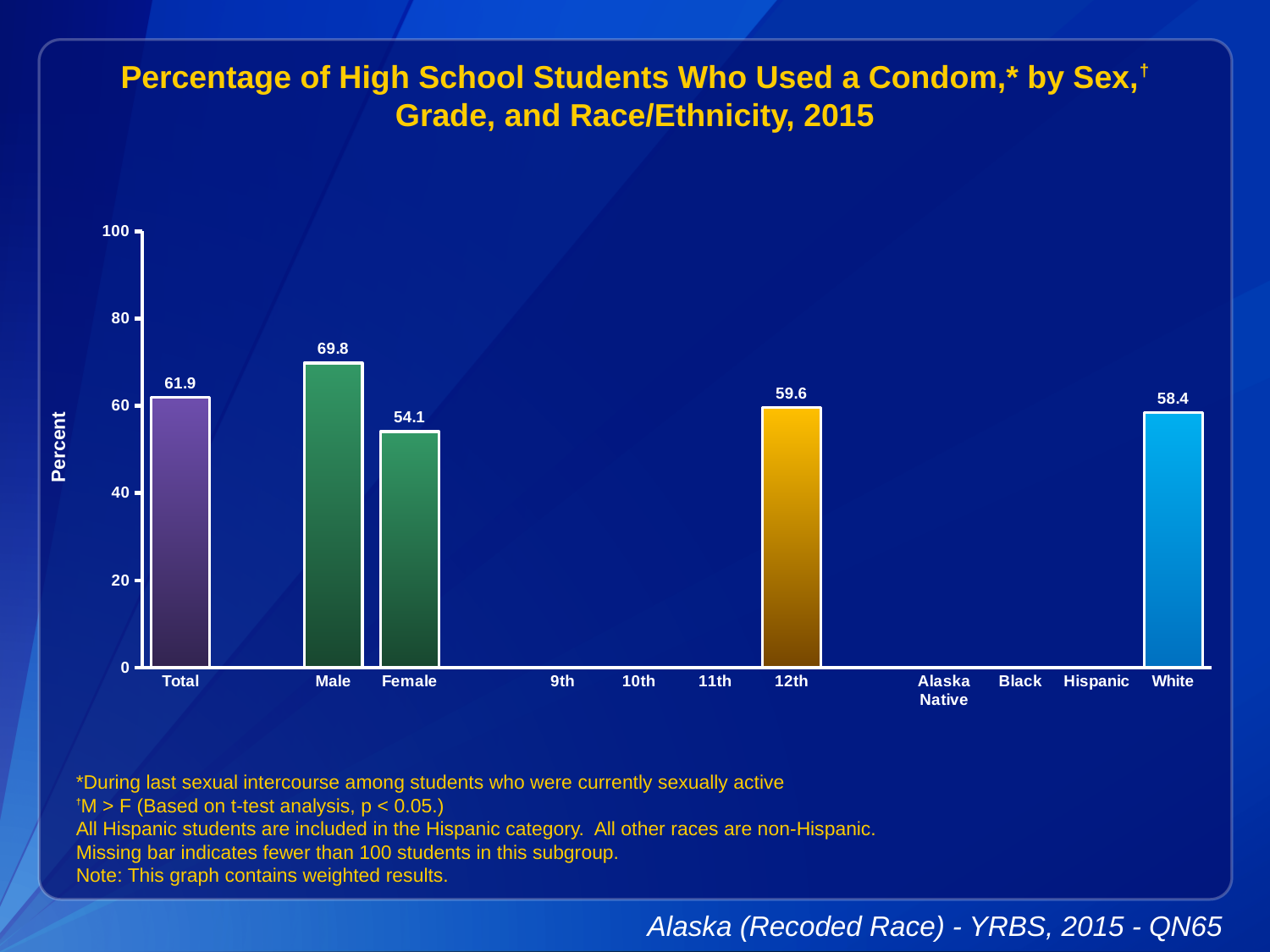
How many categories have a bar plotted? 5 What is the value for Total? 61.9 What kind of chart is this? bar chart Which category has the highest value? Male What is the difference between the values for Male and Female? 15.7 Is the value for Total greater or less than 60? greater Which category with a plotted bar has the lowest value? Female Which is larger, the value for 12th or the value for White? 12th What is the value for White? 58.4 What is the value for Female? 54.1 What is the value for 12th? 59.6 What is the value for Male? 69.8